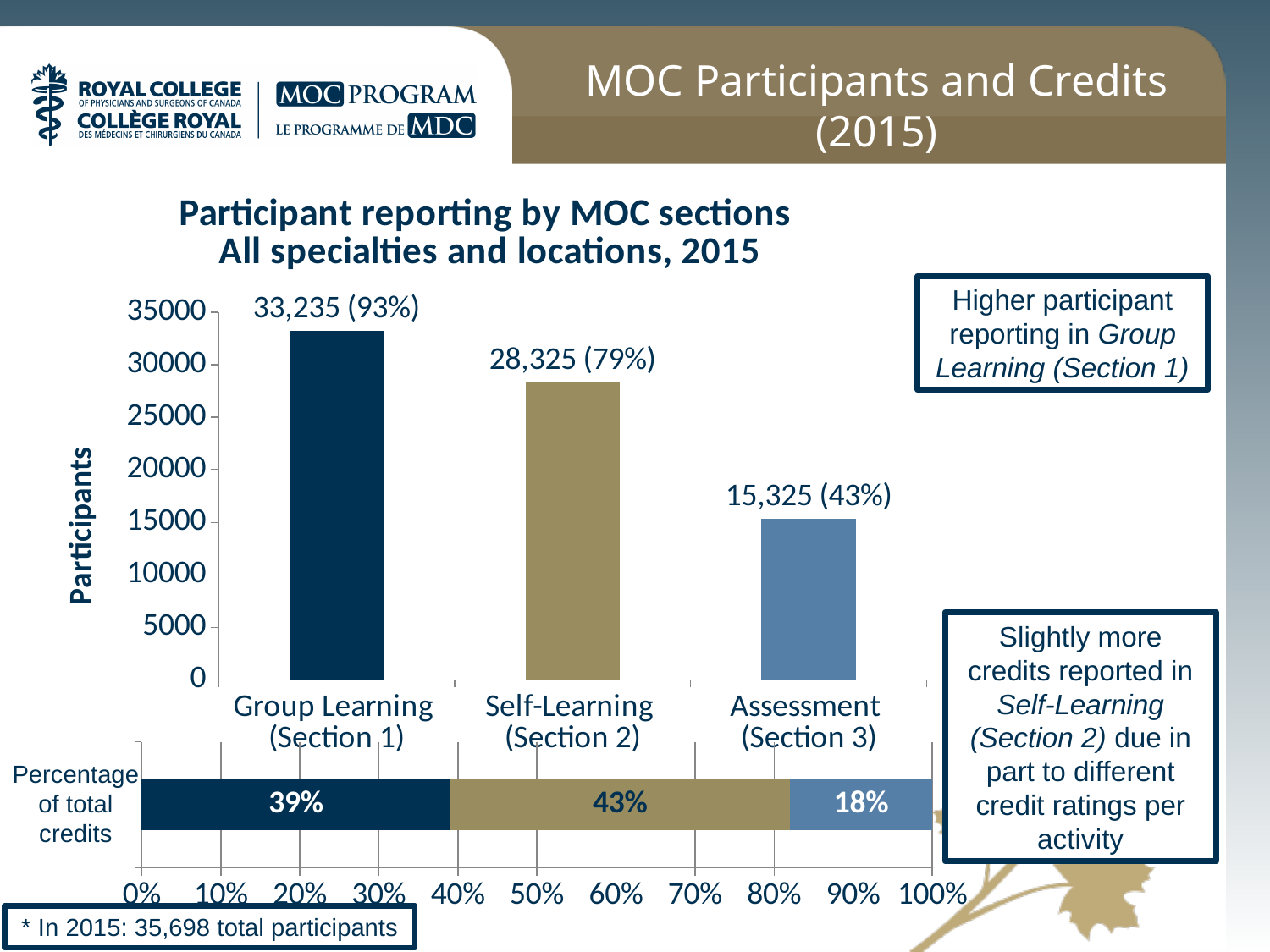
In the 'Participant reporting by MOC sections' chart, which section has the lowest number of participants? Assessment (Section 3) In the 'Participant reporting by MOC sections' chart, what is the data label for Self-Learning (Section 2)? 28,325 (79%) In the 'Participant reporting by MOC sections' chart, what is the difference in participants between Self-Learning (Section 2) and Assessment (Section 3)? 13,000 In the 'Participant reporting by MOC sections' chart, which section has the highest number of participants? Group Learning (Section 1) In the 'Percentage of total credits' bar at the bottom of the slide, which section has the smallest share of credits? Assessment (Section 3) In the 'Participant reporting by MOC sections' chart, how many sections (categories) are plotted? 3 In the 'Participant reporting by MOC sections' chart, what is the difference in participants between Group Learning (Section 1) and Self-Learning (Section 2)? 4,910 In the 'Participant reporting by MOC sections' chart, what percentage is shown for Assessment (Section 3)? 43% What type of chart is the 'Participant reporting by MOC sections' chart? Bar chart In the 'Percentage of total credits' bar at the bottom of the slide, what share is shown for Self-Learning (Section 2)? 43% In the 'Participant reporting by MOC sections' chart, how many participants are shown for Group Learning (Section 1)? 33,235 In the 'Percentage of total credits' bar at the bottom of the slide, is the share for Group Learning (Section 1) larger or smaller than the share for Self-Learning (Section 2)? Smaller